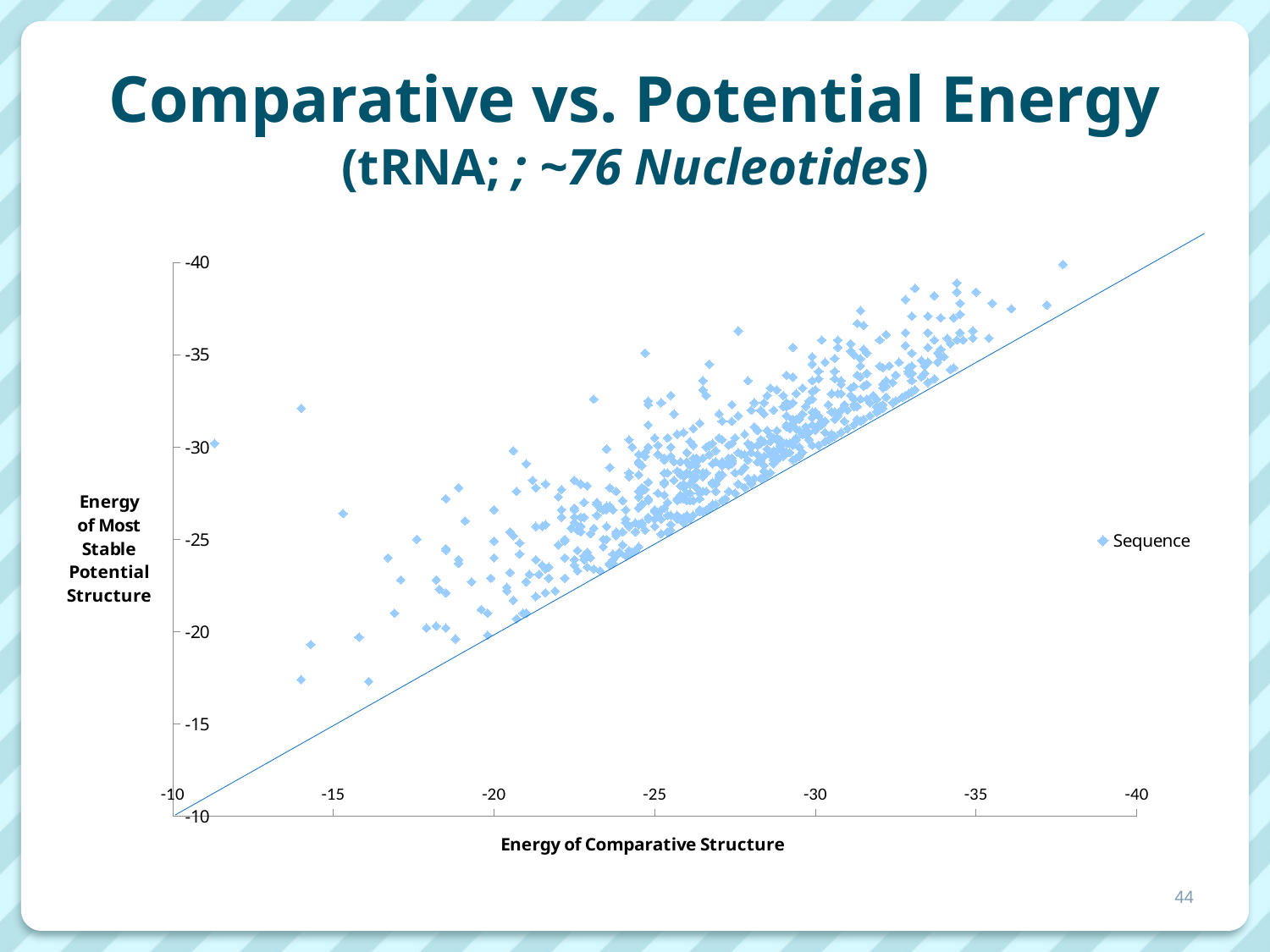
What is the title of the x axis? Energy of Comparative Structure What is the name of the series shown in the legend? Sequence How many series does the legend list? 1 What value is labelled at the right end of the x axis? -40 Moving from left to right along the x axis, do the plotted points generally move upward or downward on the chart? upward What kind of chart is shown on the slide? scatter chart What value is labelled at the left end of the x axis? -10 What value is labelled at the top of the y axis? -40